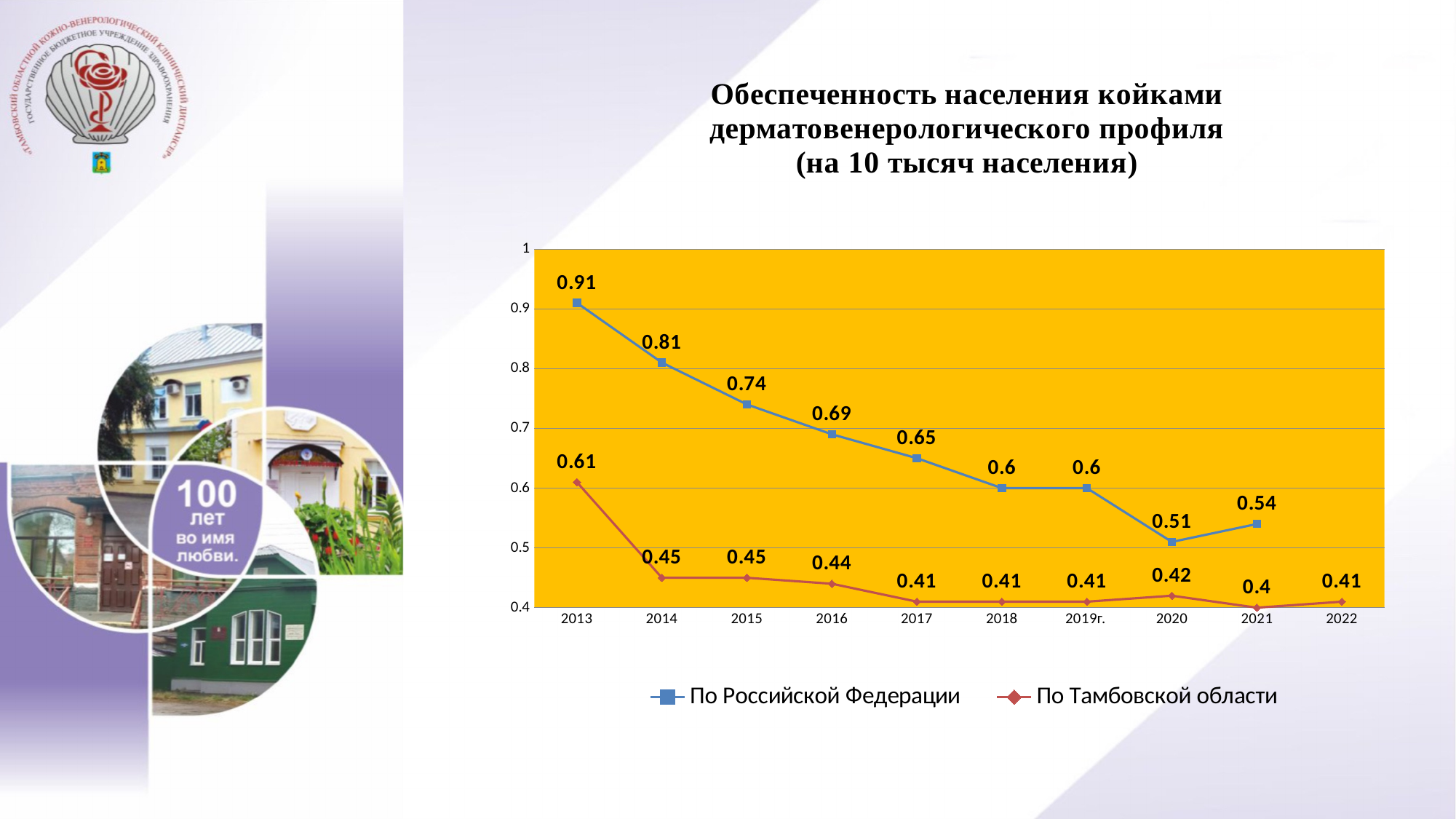
In which year is the value for По Российской Федерации the lowest? 2020 What type of chart is shown on the slide? line chart What is the value for По Российской Федерации in 2013? 0.91 How many years are shown on the x axis? 10 Which series has the larger value in 2017, По Российской Федерации or По Тамбовской области? По Российской Федерации What is the difference between the По Российской Федерации and По Тамбовской области values in 2014? 0.36 Does the value for По Российской Федерации rise or fall from 2013 to 2020? fall What is the value for По Тамбовской области in 2016? 0.44 What is the value for По Российской Федерации in 2021? 0.54 What is the value for По Тамбовской области in 2021? 0.4 In which year is the value for По Тамбовской области the highest? 2013 How many series does the legend list? 2